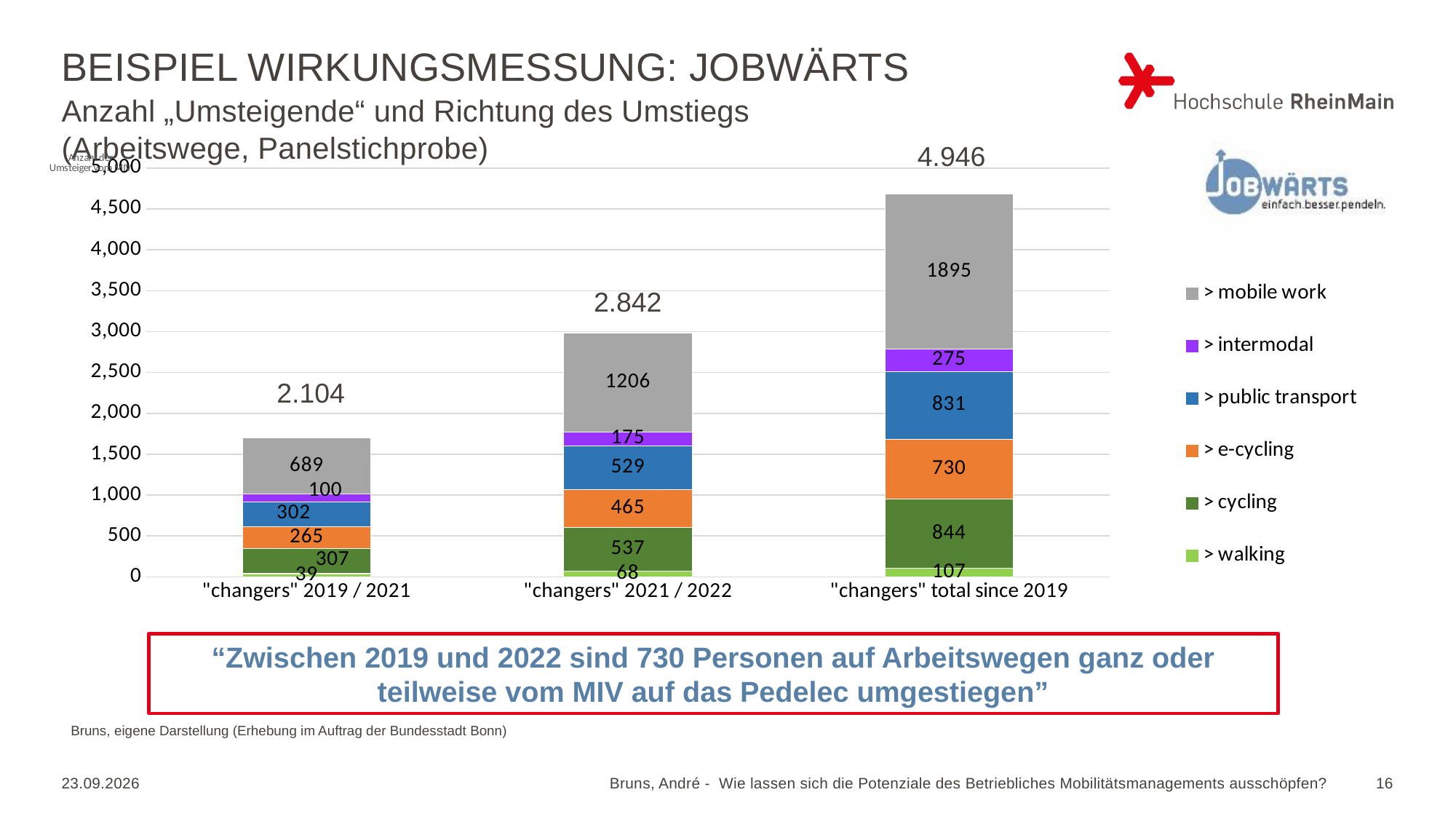
What is the value of the mobile work segment for "changers" total since 2019? 1895 Which category has the largest mobile work segment? "changers" total since 2019 What is the value of the walking segment for "changers" 2019 / 2021? 39 For "changers" total since 2019, which is larger: the e-cycling segment or the public transport segment? public transport What is the value of the e-cycling segment for "changers" 2021 / 2022? 465 What number is printed above the bar for "changers" total since 2019? 4.946 How many categories are shown on the x axis? 3 How much larger is the cycling segment for "changers" total since 2019 than for "changers" 2019 / 2021? 537 Which category has the smallest walking segment? "changers" 2019 / 2021 What kind of chart is shown on the slide? stacked bar chart What is the value of the public transport segment for "changers" 2021 / 2022? 529 How many series does the legend list? 6